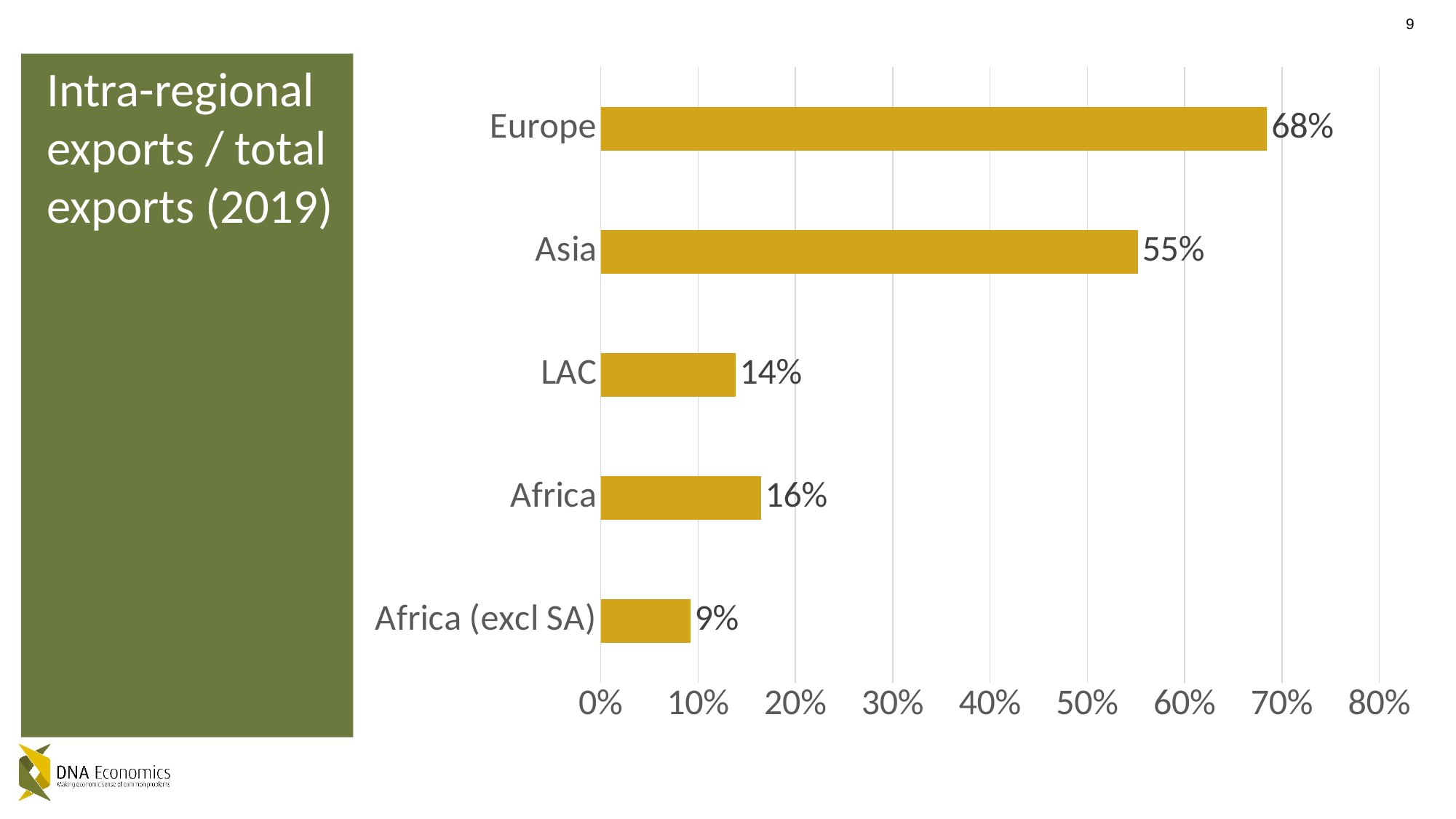
Is the value for Asia greater or less than 50%? greater What is the value for LAC? 14% Which region has the highest share of intra-regional exports in total exports? Europe What kind of chart is shown on the slide? Bar chart What is the value for Africa (excl SA)? 9% What is the value for Asia? 55% What is the value for Europe? 68% Which category has the lowest value? Africa (excl SA) How many categories are shown in the chart? 5 Which is larger, the value for Africa or the value for LAC? Africa What is the difference between the values for Europe and Asia? 13% What is the difference between the values for Africa and Africa (excl SA)? 7%